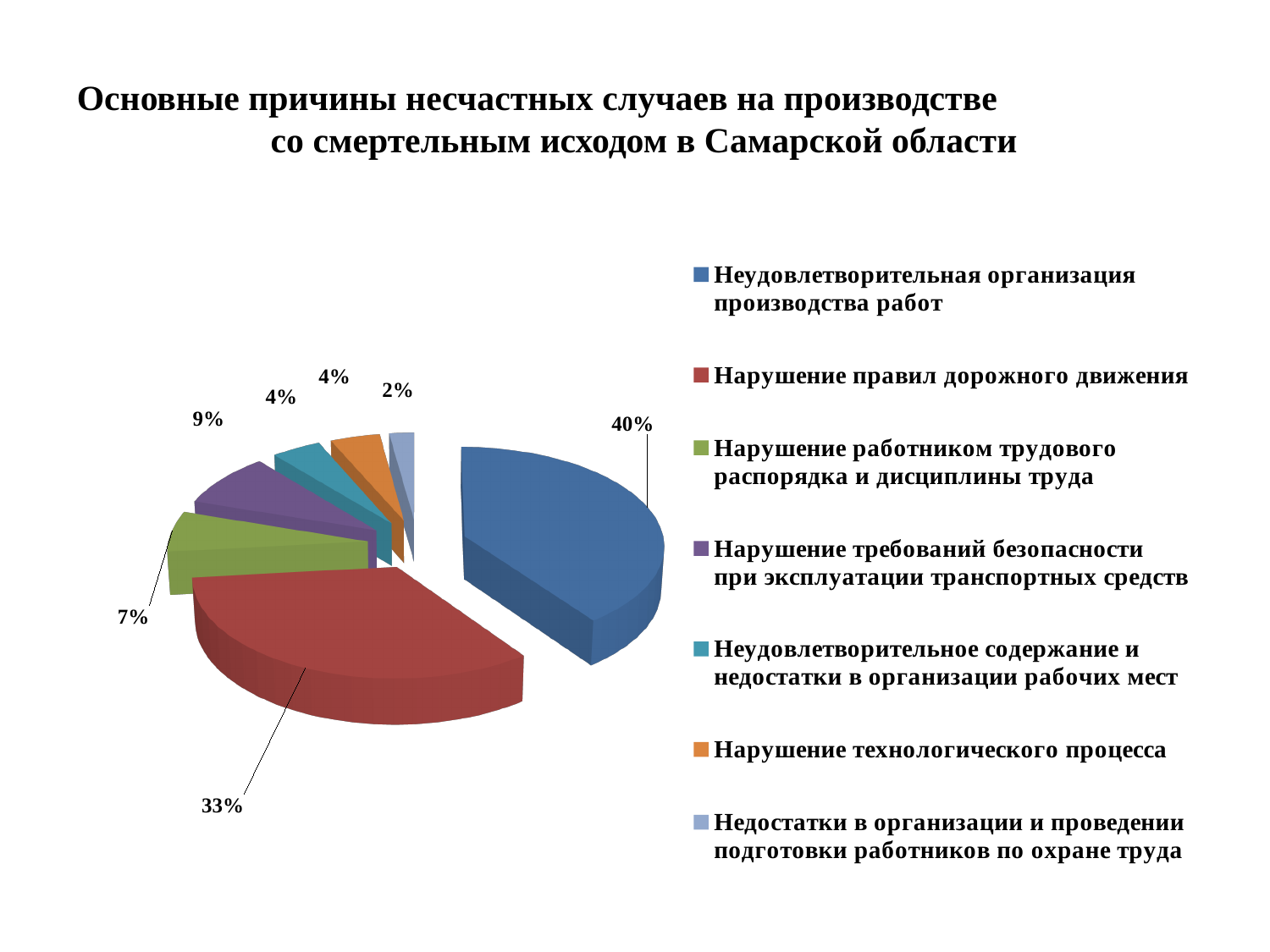
What colour is the slice for "Нарушение технологического процесса"? Orange What share of the pie is labelled for "Неудовлетворительная организация производства работ"? 40% What share of the pie is labelled for "Недостатки в организации и проведении подготовки работников по охране труда"? 2% What share of the pie is labelled for "Нарушение требований безопасности при эксплуатации транспортных средств"? 9% Which cause has the smallest slice of the pie? Недостатки в организации и проведении подготовки работников по охране труда How many slices does the pie chart have? 7 What share of the pie is labelled for "Нарушение правил дорожного движения"? 33% What share of the pie is labelled for "Нарушение работником трудового распорядка и дисциплины труда"? 7% Which slice is larger: "Нарушение требований безопасности при эксплуатации транспортных средств" or "Нарушение работником трудового распорядка и дисциплины труда"? Нарушение требований безопасности при эксплуатации транспортных средств What kind of chart is shown on the slide? Pie chart Which cause has the largest slice of the pie? Неудовлетворительная организация производства работ What is the difference in percentage points between the slices for "Неудовлетворительная организация производства работ" and "Нарушение правил дорожного движения"? 7